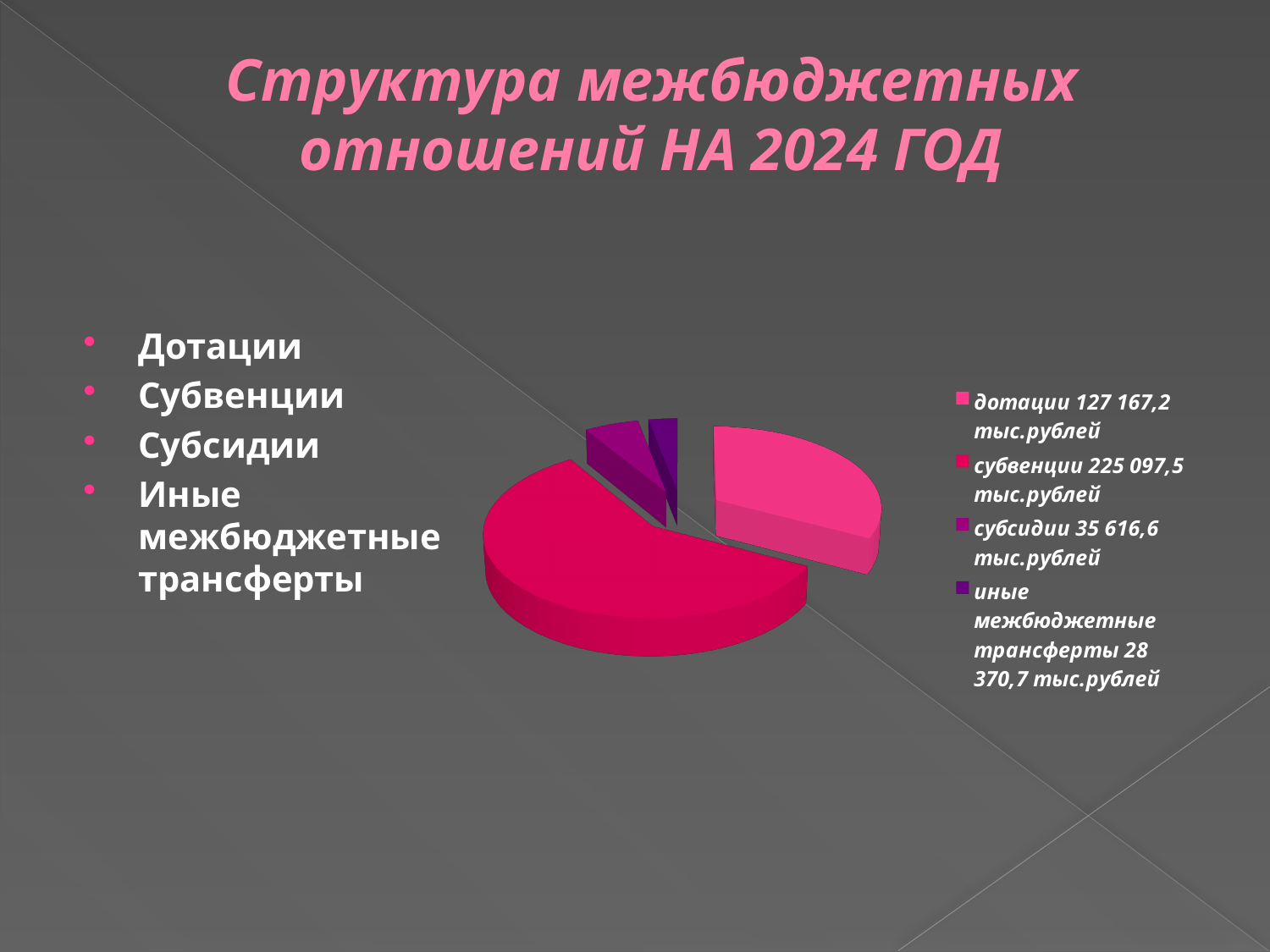
Which category has the smallest value in the pie chart? иные межбюджетные трансферты What is the value for субсидии in the pie chart? 35 616,6 тыс.рублей What is the difference between the values for субвенции and дотации? 97 930,3 тыс.рублей Which category has the largest value in the pie chart? субвенции What is the value for иные межбюджетные трансферты in the pie chart? 28 370,7 тыс.рублей What is the total of all four categories in the pie chart? 416 252,0 тыс.рублей Which is larger in the pie chart: дотации or субсидии? дотации What is the value for дотации in the pie chart? 127 167,2 тыс.рублей How many slices does the pie chart have? 4 What is the title of the slide containing the pie chart? Структура межбюджетных отношений НА 2024 ГОД What kind of chart is shown on the slide? Pie chart What is the value for субвенции in the pie chart? 225 097,5 тыс.рублей